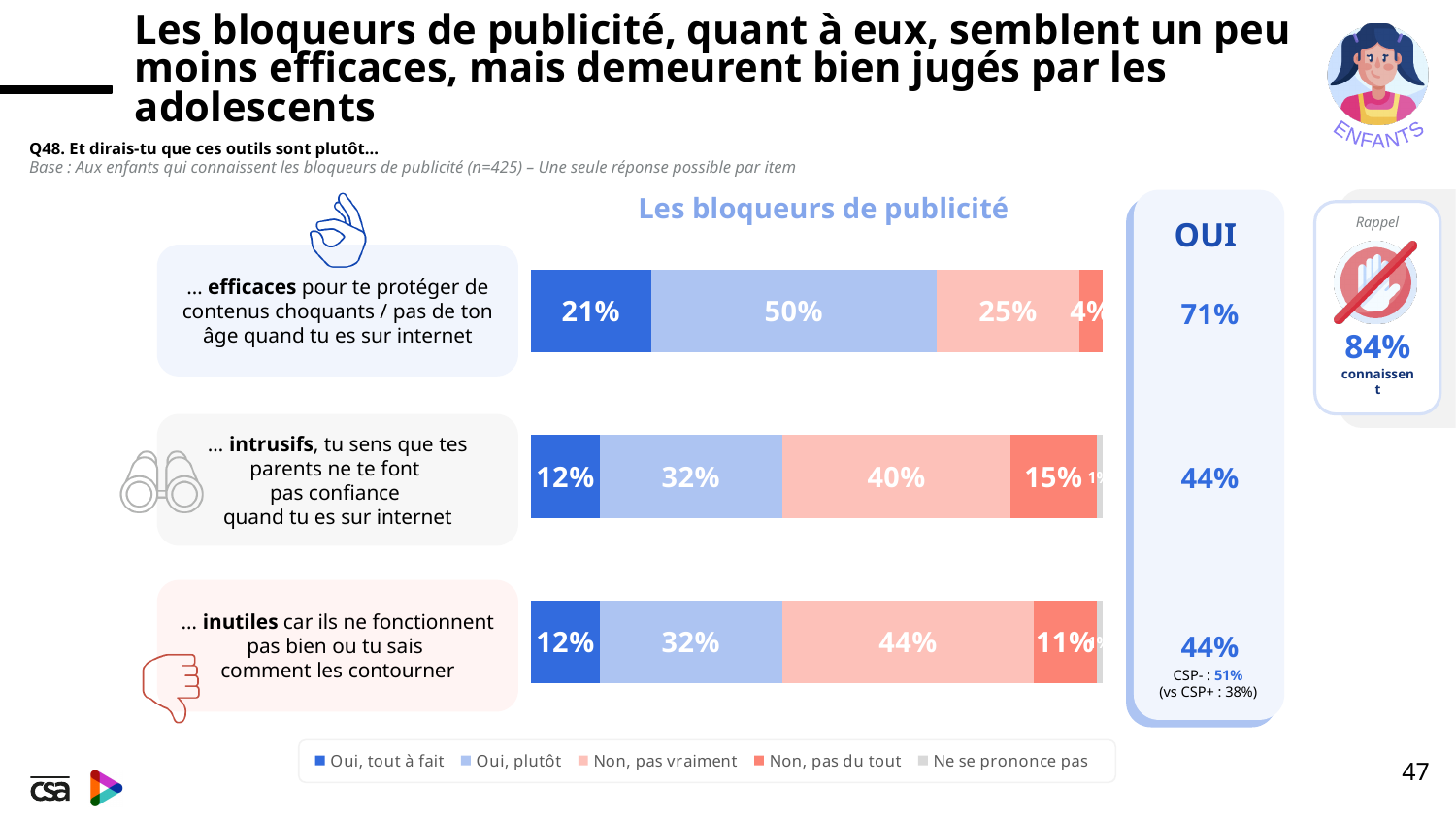
Which item has the highest 'Oui, tout à fait' value? … efficaces pour te protéger de contenus choquants Is the 'Non, pas vraiment' value larger for '… intrusifs' or for '… inutiles'? … inutiles What is the 'OUI' total shown for the item '… efficaces'? 71% What kind of chart is shown on the slide? stacked bar chart Which item has the highest 'Non, pas vraiment' value? … inutiles What is the 'Oui, tout à fait' value for the item '… efficaces pour te protéger de contenus choquants'? 21% How many series does the legend list? 5 What is the 'Non, pas du tout' value for the item '… inutiles'? 11% What is the 'Oui, plutôt' value for the item '… efficaces pour te protéger de contenus choquants'? 50% What is the difference between the 'Non, pas du tout' values for '… intrusifs' and '… inutiles'? 4% How many items (categories) are plotted in the chart? 3 What is the 'Non, pas vraiment' value for the item '… intrusifs'? 40%